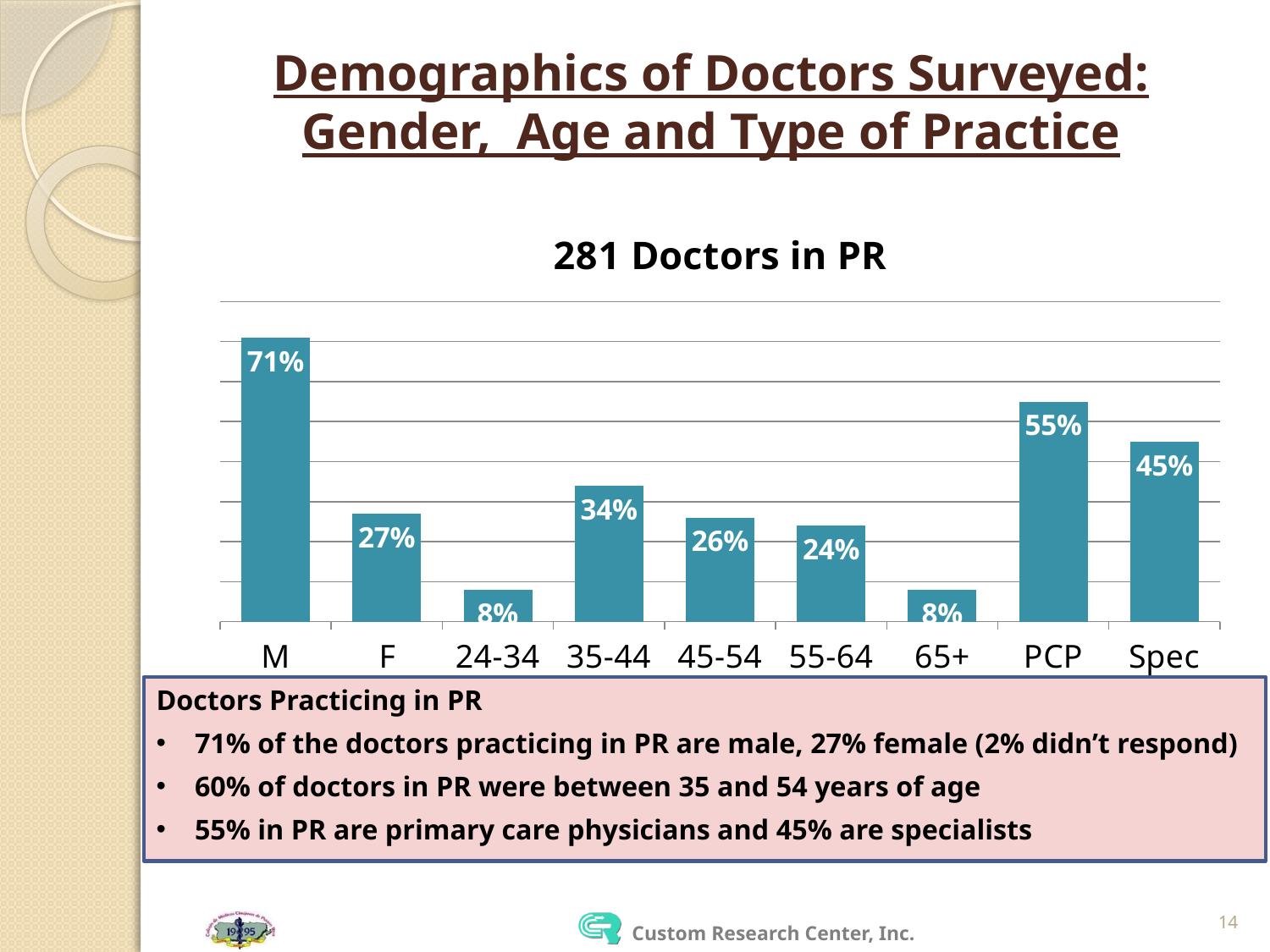
What kind of chart is shown on the slide? bar chart Which category has the highest value? M What is the value for the 65+ age group? 8% What is the value for M? 71% Which is larger, the value for F or the value for 35-44? 35-44 What is the title of the chart? 281 Doctors in PR Which is larger, the value for 45-54 or the value for 55-64? 45-54 How many categories are shown on the x axis? 9 What is the value for PCP? 55% What is the value for the 35-44 age group? 34% What is the difference between the values for M and F? 44% What is the difference between the values for PCP and Spec? 10%